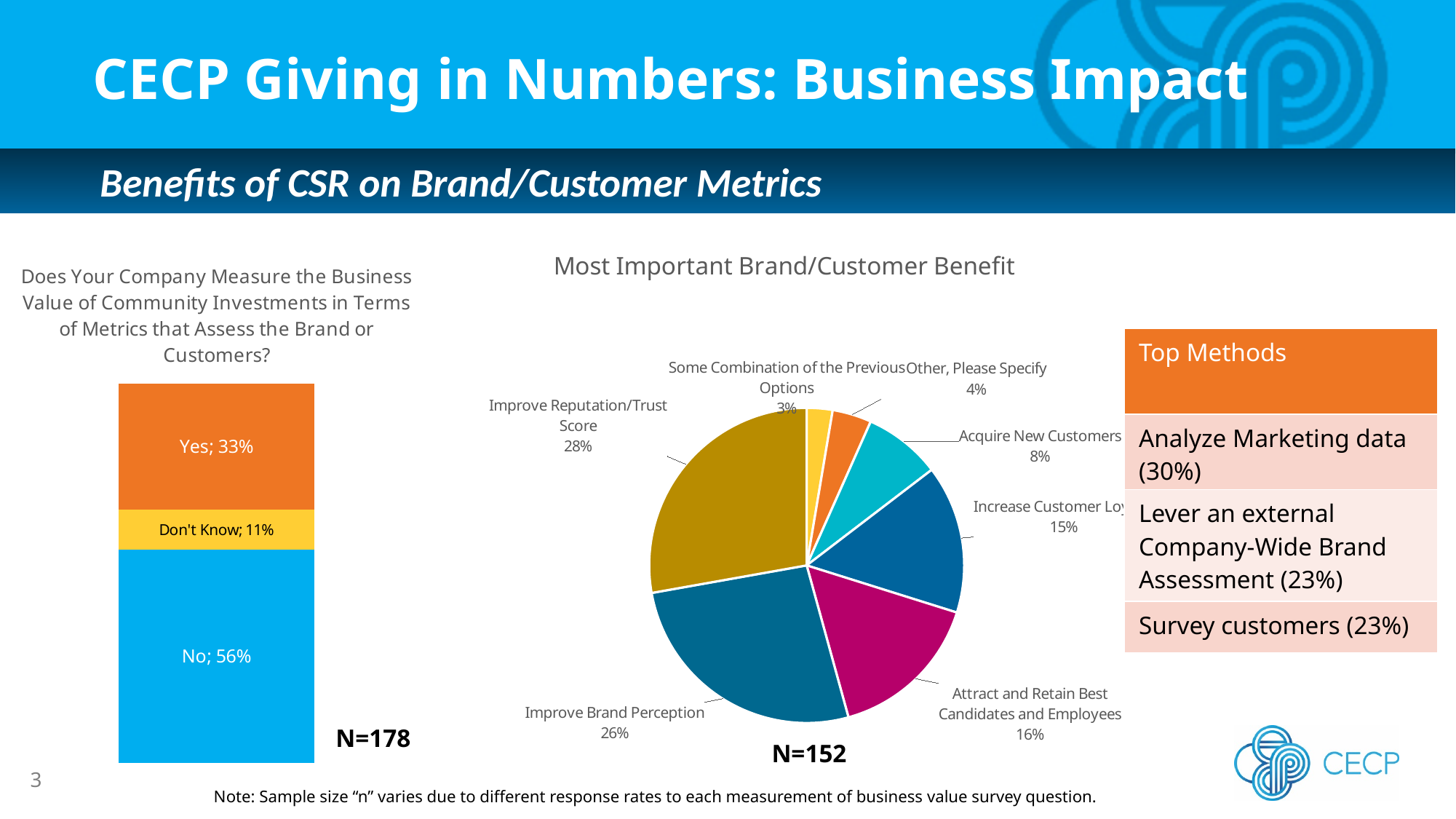
In the "Most Important Brand/Customer Benefit" chart, which slice is the largest? Improve Reputation/Trust Score In the "Most Important Brand/Customer Benefit" chart, what share is "Improve Brand Perception"? 26% In the left chart, which response has the smallest share? Don't Know What kind of chart is the "Most Important Brand/Customer Benefit" chart? Pie chart In the "Most Important Brand/Customer Benefit" chart, which slice is the smallest? Some Combination of the Previous Options In the left chart, what percentage of companies answered "Yes"? 33% How many slices does the "Most Important Brand/Customer Benefit" pie chart have? 7 In the left chart, what percentage of companies answered "No"? 56% In the "Most Important Brand/Customer Benefit" chart, which is larger: "Acquire New Customers" or "Attract and Retain Best Candidates and Employees"? Attract and Retain Best Candidates and Employees In the "Most Important Brand/Customer Benefit" chart, what share is "Improve Reputation/Trust Score"? 28% What kind of chart is the left chart? Bar chart In the left chart, what is the difference between the "No" and "Yes" percentages? 23%